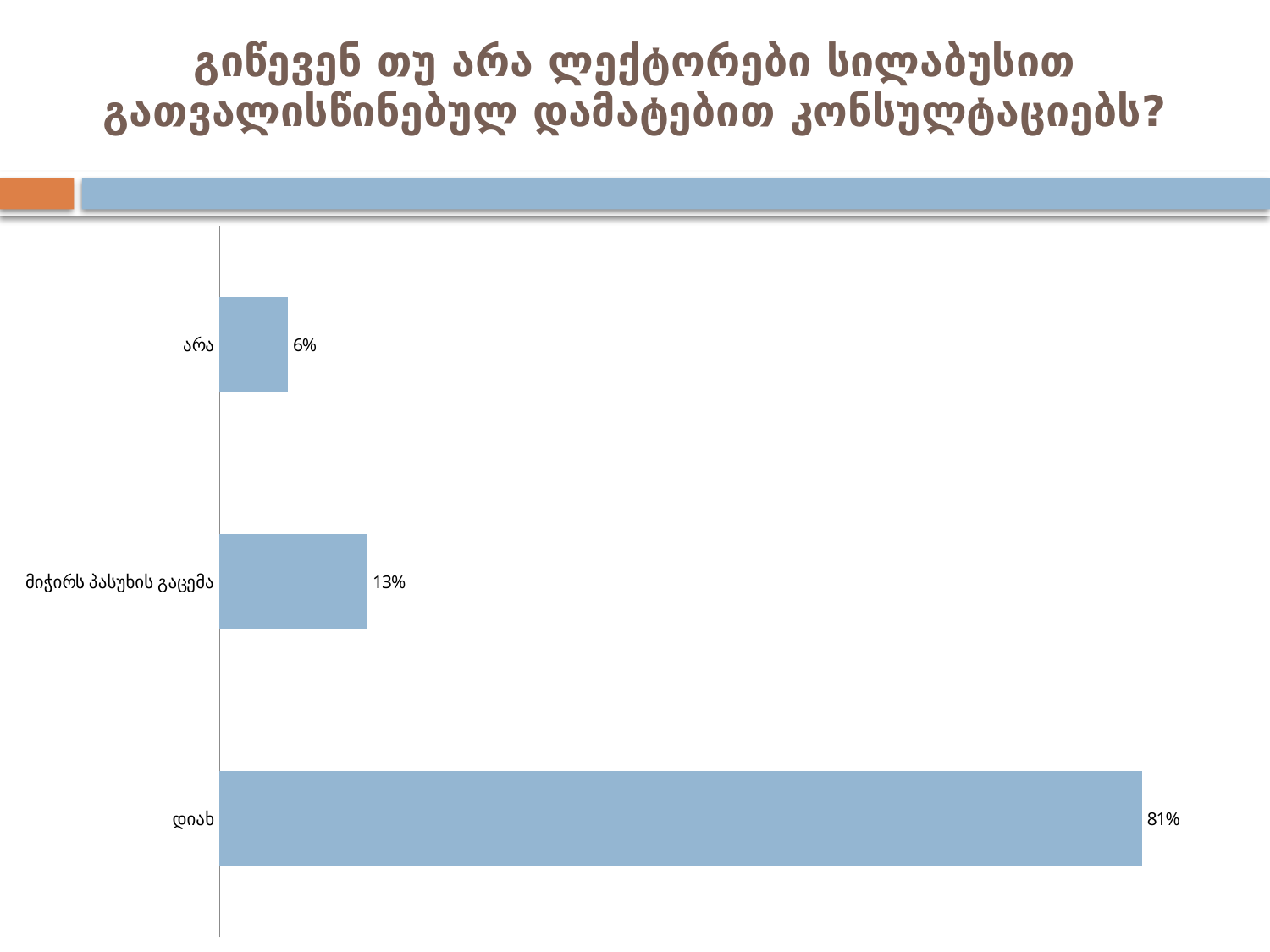
What is the value for "არა"? 6% How many categories are shown in the chart? 3 What kind of chart is shown on the slide? bar chart What is the total of the three values shown in the chart? 100% What is the value for "მიჭირს პასუხის გაცემა"? 13% Which category has the lowest value? არა Which is larger, the value for "არა" or the value for "მიჭირს პასუხის გაცემა"? მიჭირს პასუხის გაცემა What is the difference between the values for "მიჭირს პასუხის გაცემა" and "არა"? 7% Which category has the highest value? დიახ What is the difference between the values for "დიახ" and "მიჭირს პასუხის გაცემა"? 68% What colour are the bars in the chart? light blue What is the value for "დიახ"? 81%